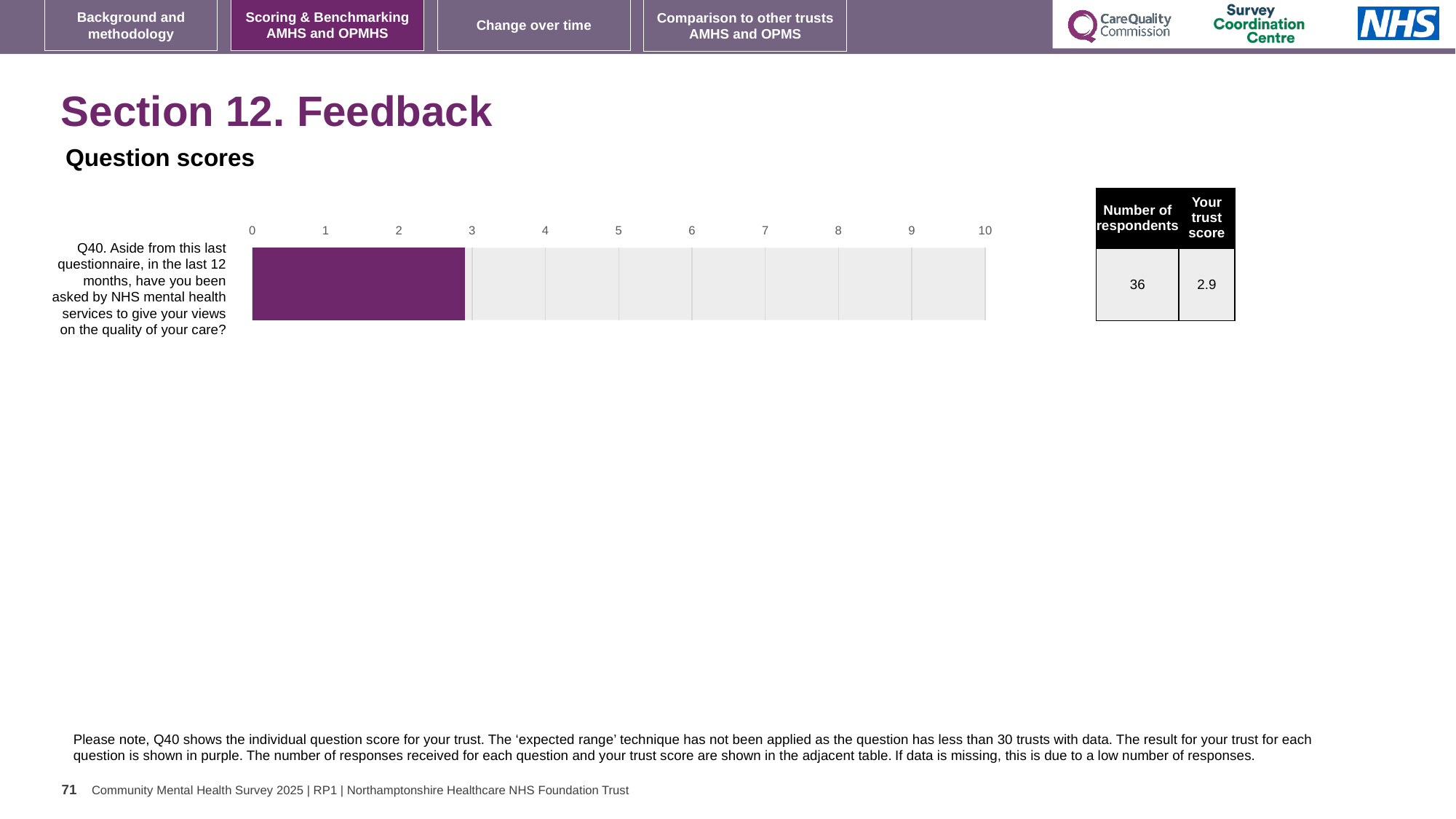
Is the bar for Q40 greater or less than 2 on the axis? greater Is the bar for Q40 greater or less than 5 on the axis? less What is the number of respondents for Q40 shown in the table? 36 What is the maximum value shown on the chart's horizontal axis? 10 What kind of chart is shown on the slide? bar chart What is the trust score for Q40 shown in the adjacent table? 2.9 How many questions (categories) are plotted in the chart? 1 Is the bar for Q40 greater or less than 3 on the axis? less What colour is the bar showing the trust's result for Q40? purple